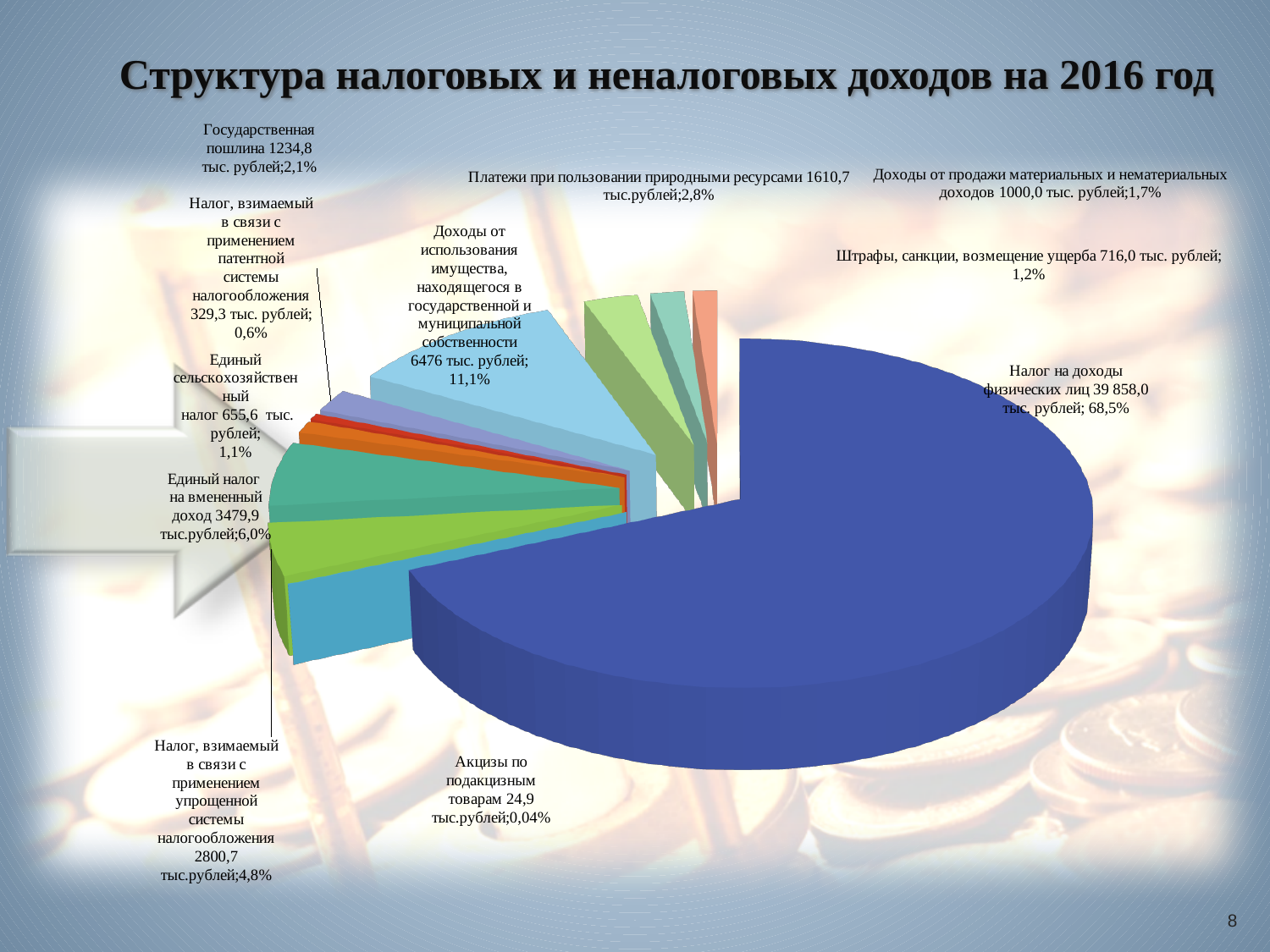
What share of the pie does 'Единый налог на вмененный доход' have? 6,0% What is the title of the chart? Структура налоговых и неналоговых доходов на 2016 год What share of the pie does 'Налог на доходы физических лиц' have? 68,5% What is the difference in percentage share between 'Единый налог на вмененный доход' and 'Налог, взимаемый в связи с применением упрощенной системы налогообложения'? 1,2% Which category has the largest slice of the pie? Налог на доходы физических лиц What kind of chart is shown on the slide? Pie chart Which is larger: 'Государственная пошлина' or 'Штрафы, санкции, возмещение ущерба'? Государственная пошлина Which category has the smallest slice of the pie? Акцизы по подакцизным товарам What is the value for 'Доходы от использования имущества, находящегося в государственной и муниципальной собственности'? 6476 тыс. рублей How many categories (slices) are labelled in the pie chart? 11 What is the value for 'Платежи при пользовании природными ресурсами'? 1610,7 тыс.рублей What is the value for 'Налог на доходы физических лиц' in тыс. рублей? 39 858,0